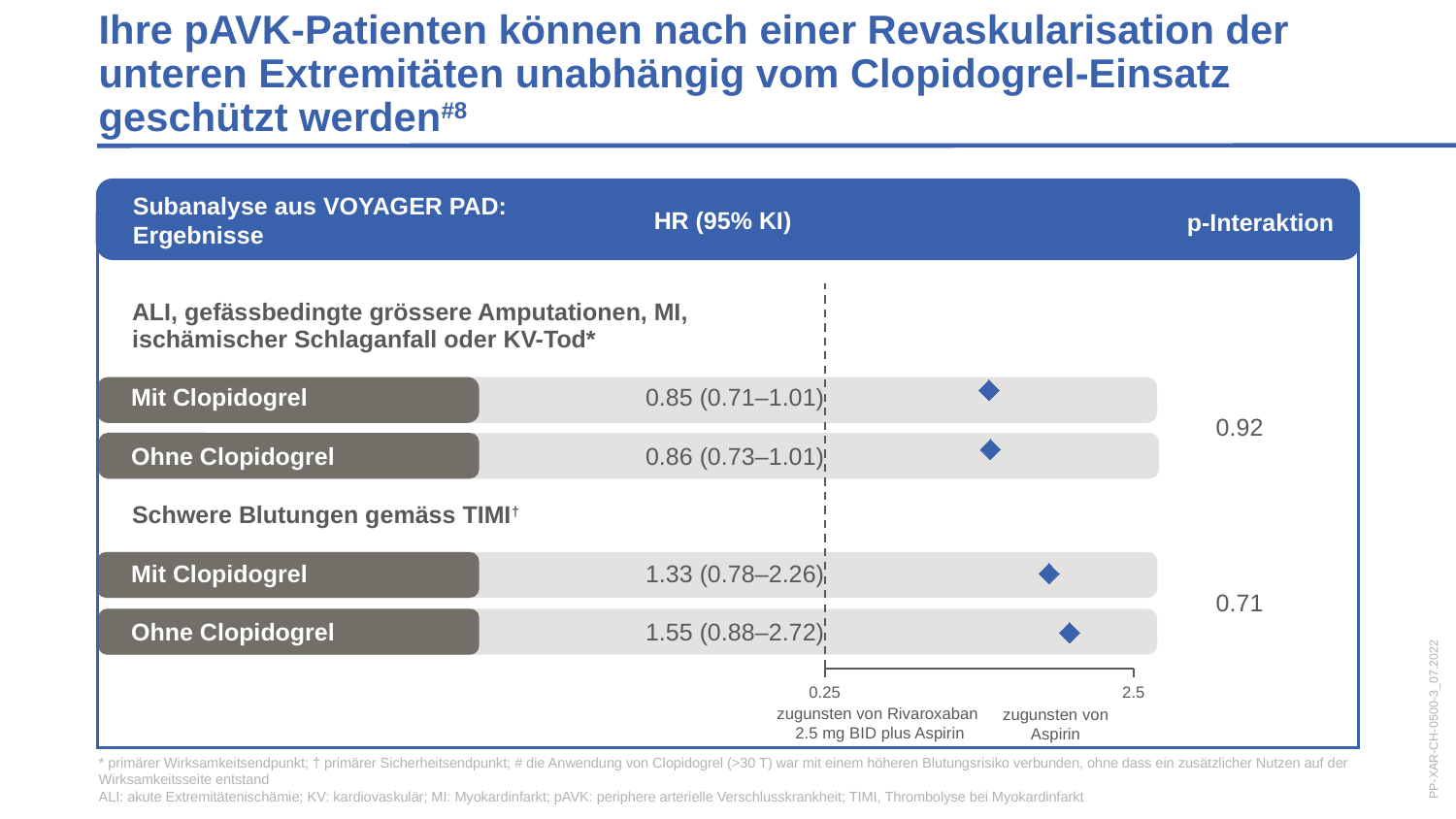
What are the two tick values shown on the horizontal axis of the plot? 0.25 and 2.5 For Schwere Blutungen gemäss TIMI, what is the difference between the HR point estimates for 'Ohne Clopidogrel' and 'Mit Clopidogrel'? 0.22 What is the p-Interaktion value for the endpoint ALI, gefässbedingte grössere Amputationen, MI, ischämischer Schlaganfall oder KV-Tod? 0.92 For Schwere Blutungen gemäss TIMI, which has the larger HR point estimate: 'Mit Clopidogrel' or 'Ohne Clopidogrel'? Ohne Clopidogrel What is the HR (95% KI) for 'Mit Clopidogrel' for Schwere Blutungen gemäss TIMI? 1.33 (0.78–2.26) What is the HR (95% KI) for 'Mit Clopidogrel' for the endpoint ALI, gefässbedingte grössere Amputationen, MI, ischämischer Schlaganfall oder KV-Tod? 0.85 (0.71–1.01) Which row has the highest hazard ratio point estimate in the plot? Ohne Clopidogrel (Schwere Blutungen gemäss TIMI) Which row has the lowest hazard ratio point estimate in the plot? Mit Clopidogrel (ALI, gefässbedingte grössere Amputationen, MI, ischämischer Schlaganfall oder KV-Tod) What is the HR (95% KI) for 'Ohne Clopidogrel' for Schwere Blutungen gemäss TIMI? 1.55 (0.88–2.72) What is the HR (95% KI) for 'Ohne Clopidogrel' for the endpoint ALI, gefässbedingte grössere Amputationen, MI, ischämischer Schlaganfall oder KV-Tod? 0.86 (0.73–1.01) How many HR rows (data points) are plotted in the chart? 4 What is the p-Interaktion value for the endpoint Schwere Blutungen gemäss TIMI? 0.71